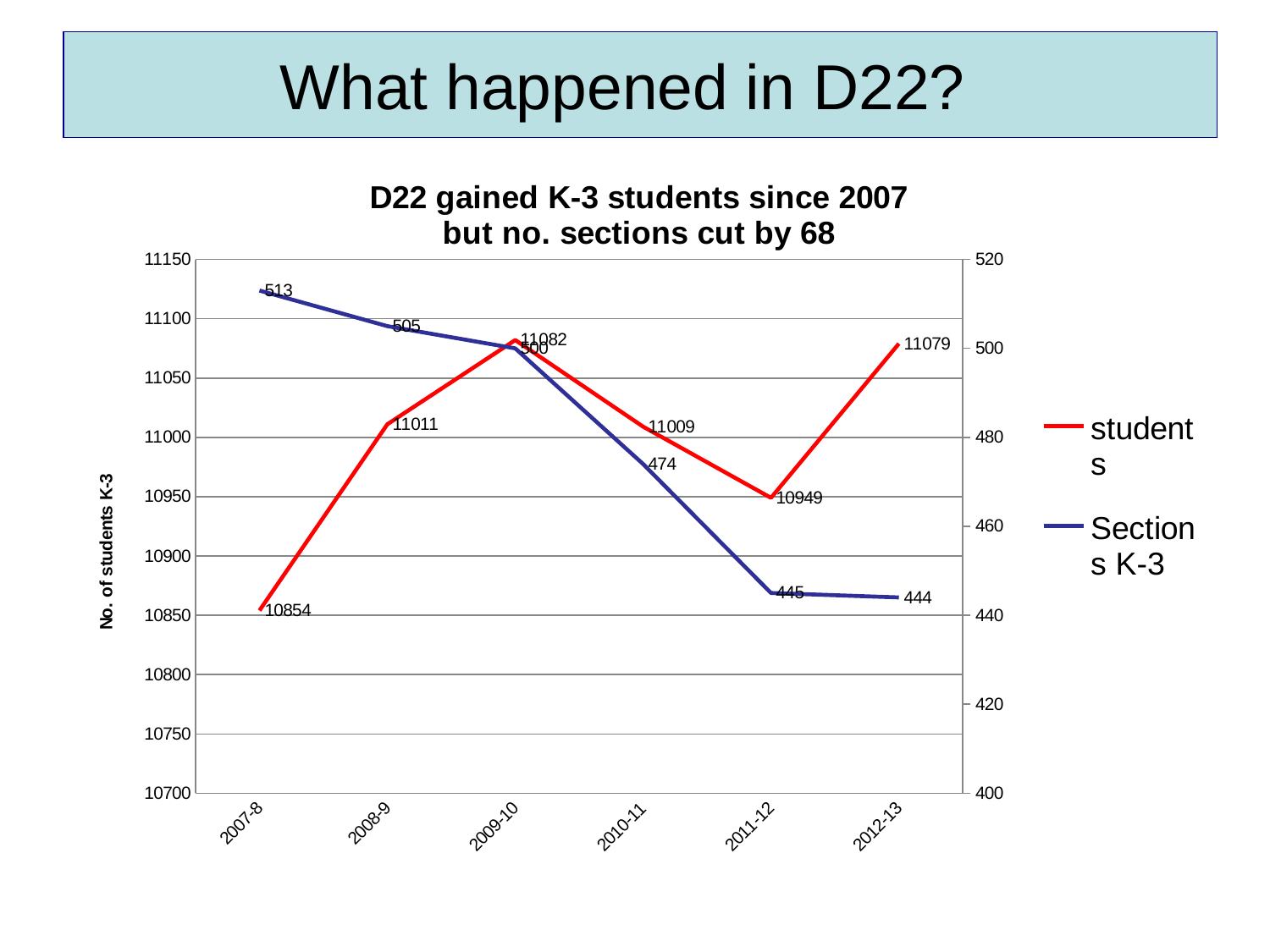
Which is larger, the number of students in 2008-9 or in 2011-12? 2008-9 How many school years are plotted along the x axis? 6 How many series does the legend list? 2 What is the difference in Sections K-3 between 2007-8 and 2012-13? 69 In which school year is the number of students highest? 2009-10 In which school year is the number of Sections K-3 lowest? 2012-13 Do the Sections K-3 values rise or fall from 2007-8 to 2012-13? fall What is the title of the chart? D22 gained K-3 students since 2007 but no. sections cut by 68 What is the number of Sections K-3 in 2011-12? 445 What is the number of K-3 students in 2007-8? 10854 What type of chart is shown on the slide? line chart What is the number of K-3 students in 2012-13? 11079